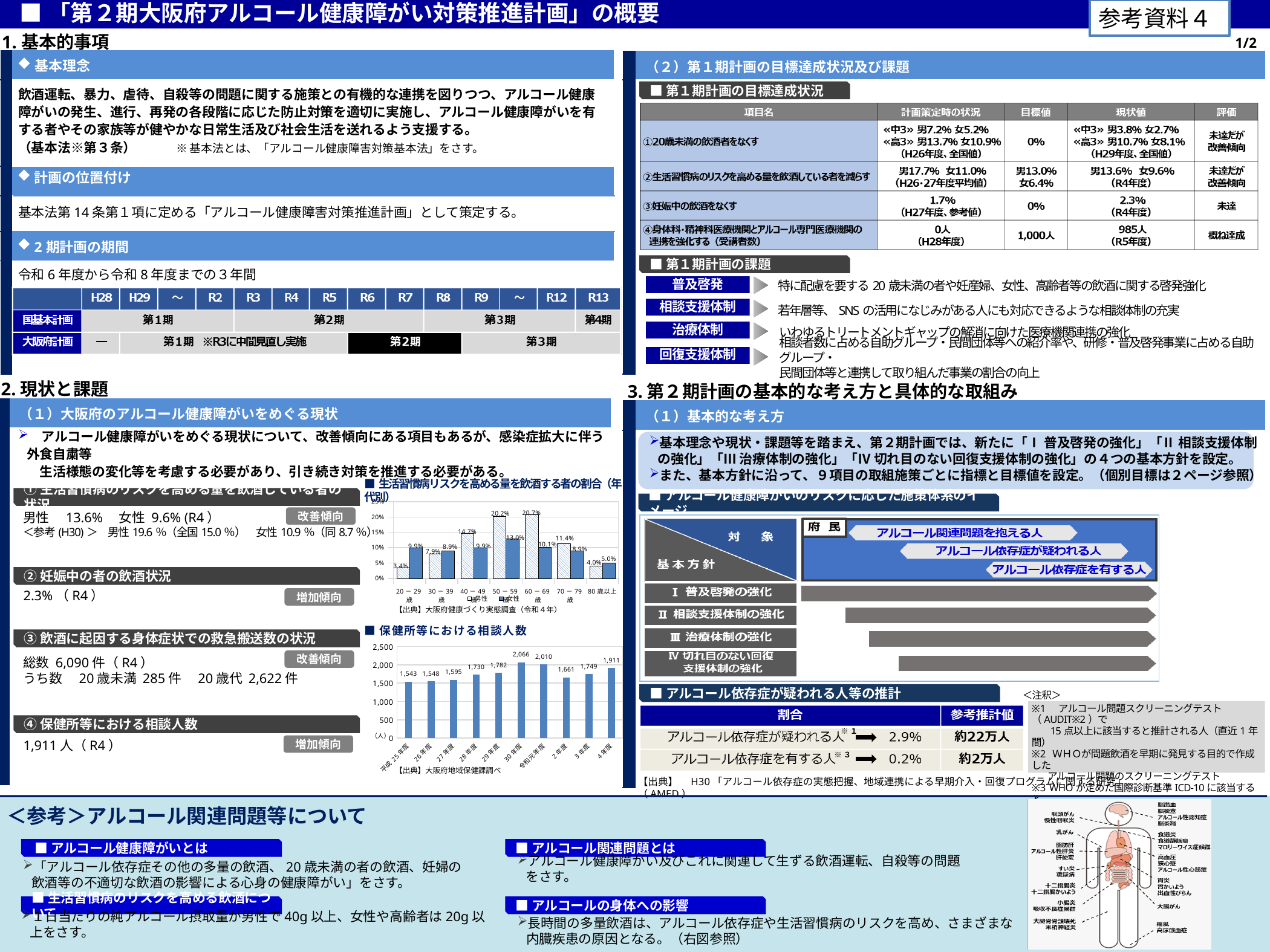
「保健所等における相談人数」のグラフで、令和4年度と令和2年度の相談人数の差はいくつですか。 250 「生活習慣病リスクを高める量を飲酒する者の割合（年代別）」のグラフで、40－49歳の男性と女性の割合の差は何ポイントですか。 4.8 「生活習慣病リスクを高める量を飲酒する者の割合（年代別）」のグラフで、50－59歳の男性の割合は何%ですか。 20.2% 「生活習慣病リスクを高める量を飲酒する者の割合（年代別）」のグラフで、男性の割合が最も高い年代はどれですか。 60－69歳 「保健所等における相談人数」のグラフで、相談人数が最も少ない年度はどれですか。 平成25年度 「生活習慣病リスクを高める量を飲酒する者の割合（年代別）」のグラフの凡例には、いくつの系列がありますか。 2 「保健所等における相談人数」のグラフで、相談人数が最も多い年度はどれですか。 平成30年度 「生活習慣病リスクを高める量を飲酒する者の割合（年代別）」のグラフで、80歳以上の女性の割合は何%ですか。 5.0% 「保健所等における相談人数」のグラフで、平成30年度の相談人数はいくつですか。 2,066 「保健所等における相談人数」のグラフには、何年度分のデータが示されていますか。 10 「保健所等における相談人数」のグラフは、どの種類のグラフですか。 棒グラフ 「生活習慣病リスクを高める量を飲酒する者の割合（年代別）」のグラフで、20－29歳では男性と女性のどちらの割合が高いですか。 女性